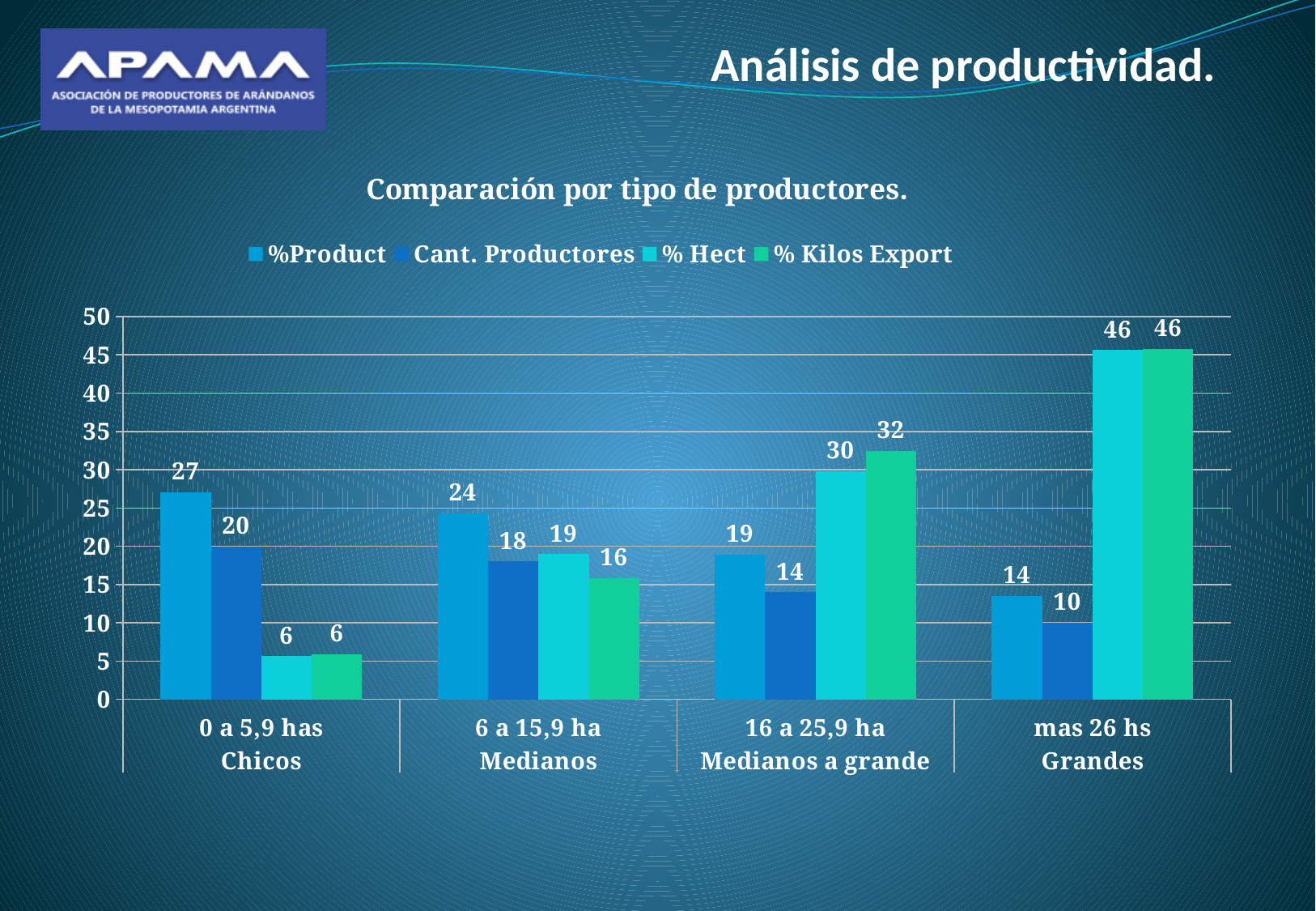
What kind of chart is shown on the slide? Bar chart What is the value of Cant. Productores for the '16 a 25,9 ha Medianos a grande' category? 14 Which is larger for the '6 a 15,9 ha Medianos' category: %Product or % Hect? %Product What is the value of %Product for the '0 a 5,9 has Chicos' category? 27 What is the title of the chart? Comparación por tipo de productores. How many series does the legend list? 4 What is the value of % Kilos Export for the 'mas 26 hs Grandes' category? 46 Which category has the lowest % Kilos Export value? 0 a 5,9 has Chicos Which category has the highest % Hect value? mas 26 hs Grandes How many categories are shown on the x axis? 4 Does the %Product value rise or fall across the categories from left to right? Fall What is the difference between % Kilos Export and % Hect for the '16 a 25,9 ha Medianos a grande' category? 2